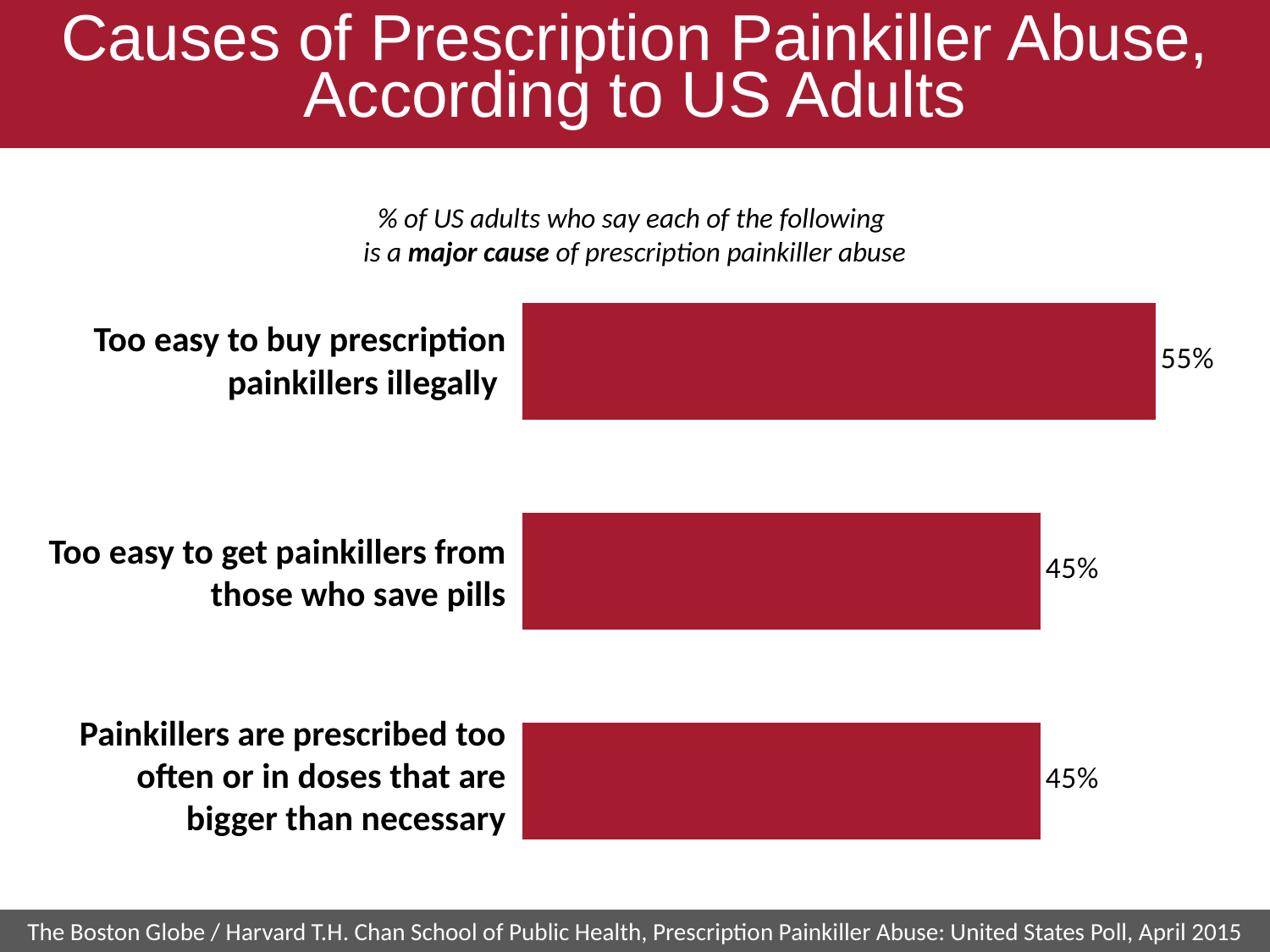
Do the two causes 'Too easy to get painkillers from those who save pills' and 'Painkillers are prescribed too often or in doses that are bigger than necessary' have the same value? Yes, both 45% Which cause has the highest percentage of US adults calling it a major cause? Too easy to buy prescription painkillers illegally What is the difference in percentage points between 'Too easy to buy prescription painkillers illegally' and 'Too easy to get painkillers from those who save pills'? 10 percentage points What is the title of the slide? Causes of Prescription Painkiller Abuse, According to US Adults What percentage of US adults say it is too easy to buy prescription painkillers illegally is a major cause of prescription painkiller abuse? 55% What kind of chart is shown on the slide? Bar chart What colour are the bars in the chart? Dark red Which is larger: the value for 'Too easy to buy prescription painkillers illegally' or the value for 'Painkillers are prescribed too often or in doses that are bigger than necessary'? Too easy to buy prescription painkillers illegally What percentage of US adults say it is too easy to get painkillers from those who save pills is a major cause? 45% How many causes are shown in the chart? 3 What percentage of US adults say painkillers are prescribed too often or in doses that are bigger than necessary is a major cause? 45%